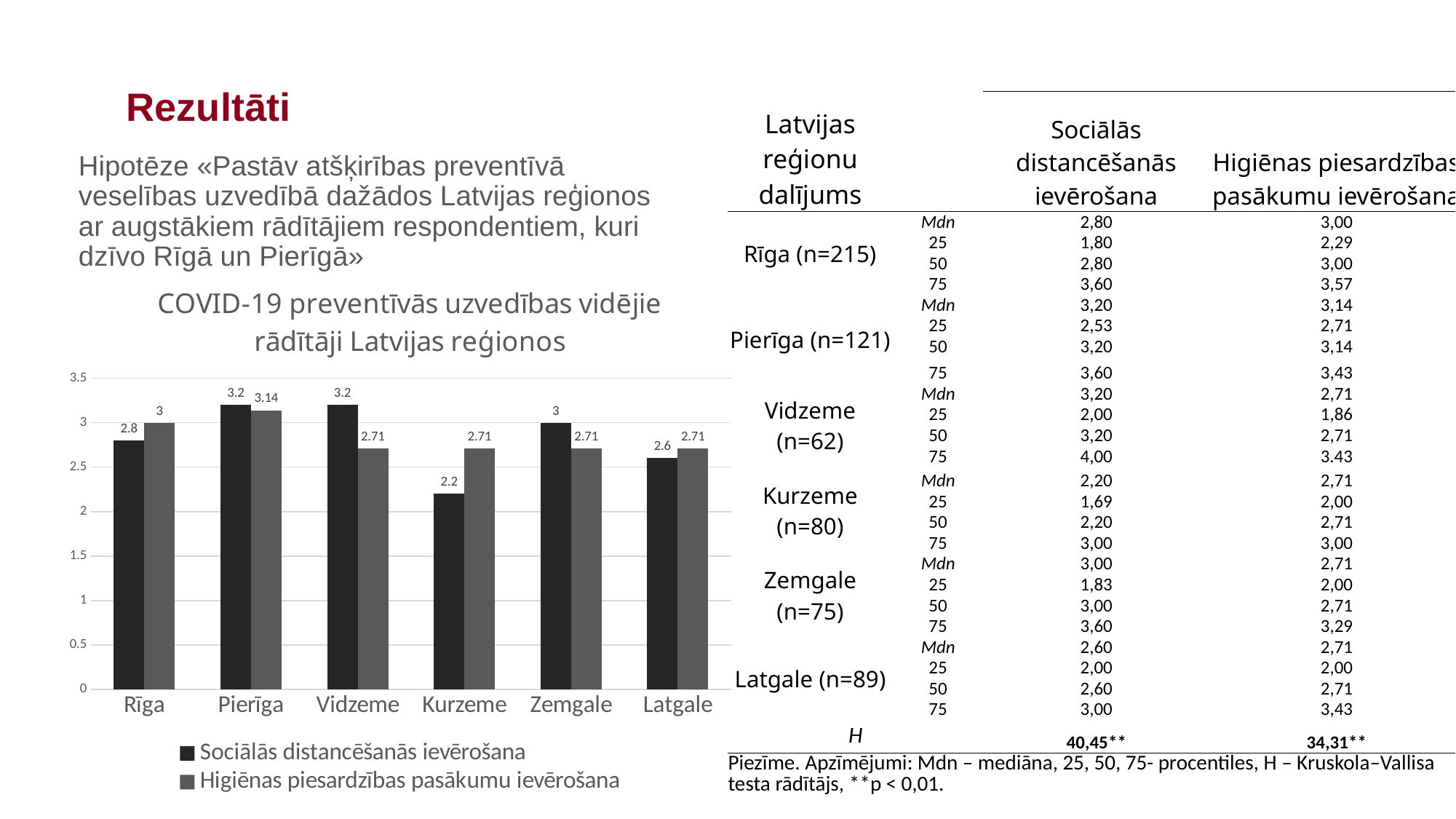
What is the value of Sociālās distancēšanās ievērošana for Kurzeme? 2.2 What is the difference between the Sociālās distancēšanās ievērošana value for Vidzeme and for Kurzeme? 1 What is the value of Higiēnas piesardzības pasākumu ievērošana for Pierīga? 3.14 What is the value of Sociālās distancēšanās ievērošana for Latgale? 2.6 For Rīga, which series has the larger value: Sociālās distancēšanās ievērošana or Higiēnas piesardzības pasākumu ievērošana? Higiēnas piesardzības pasākumu ievērošana What type of chart is shown on the slide? bar chart How many regions are shown on the x axis of the chart? 6 Which region has the highest value for Higiēnas piesardzības pasākumu ievērošana? Pierīga What is the title of the chart? COVID-19 preventīvās uzvedības vidējie rādītāji Latvijas reģionos Which region has the lowest value for Sociālās distancēšanās ievērošana? Kurzeme How many series does the chart legend list? 2 Is the value of Sociālās distancēšanās ievērošana for Zemgale greater or less than 2.5? greater